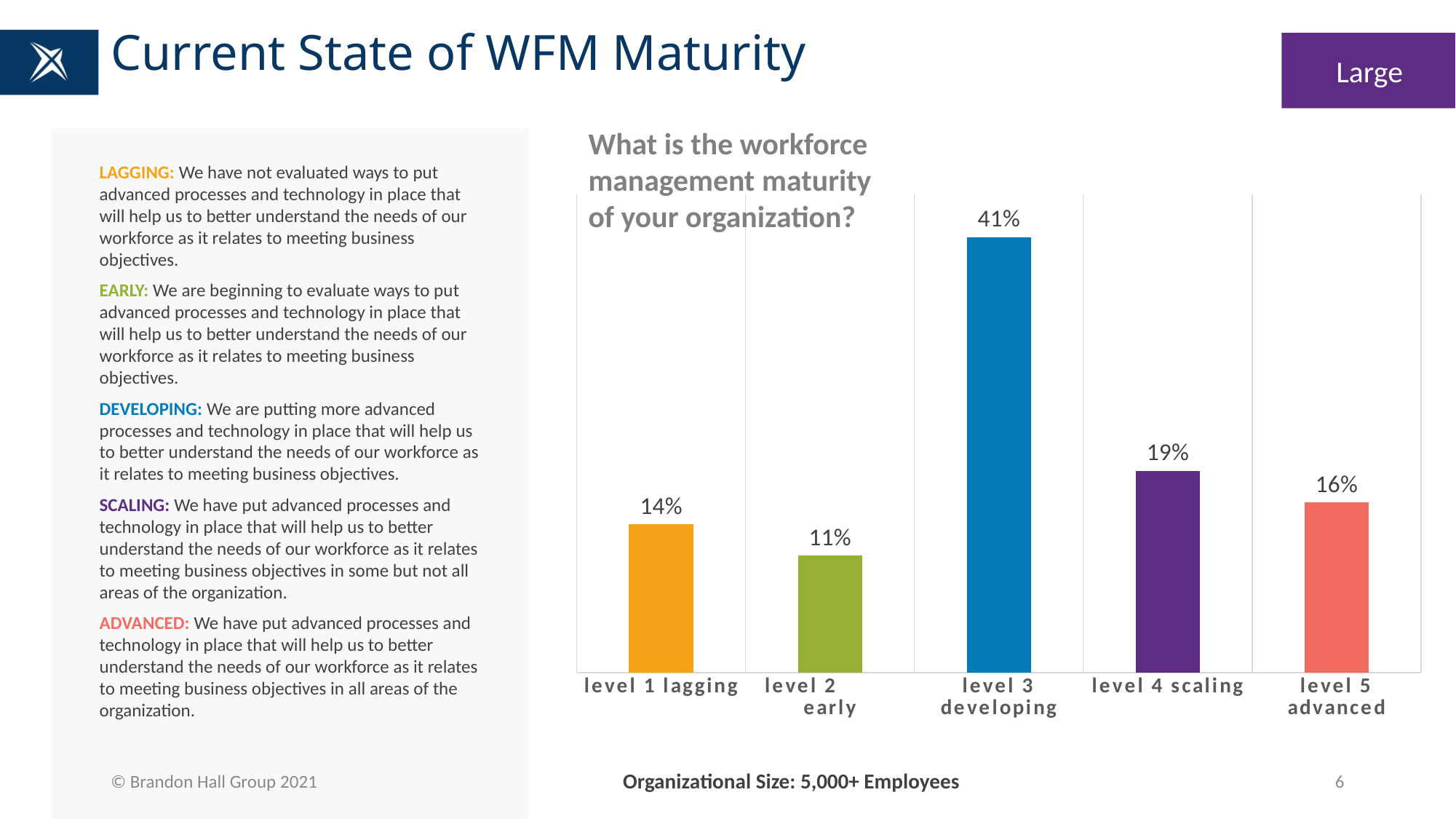
What is the value shown for level 1 lagging? 14% What is the value shown for level 5 advanced? 16% What percentage of organizations are at level 3 developing? 41% What is the difference between the values for level 3 developing and level 4 scaling? 22% What is the difference between the values for level 1 lagging and level 2 early? 3% What colour is the bar for level 3 developing? blue What question does the chart title ask? What is the workforce management maturity of your organization? Which is larger, the value for level 4 scaling or the value for level 5 advanced? level 4 scaling How many maturity levels are shown in the chart? 5 What kind of chart is shown on the slide? bar chart Which maturity level has the lowest percentage? level 2 early Which maturity level has the highest percentage? level 3 developing